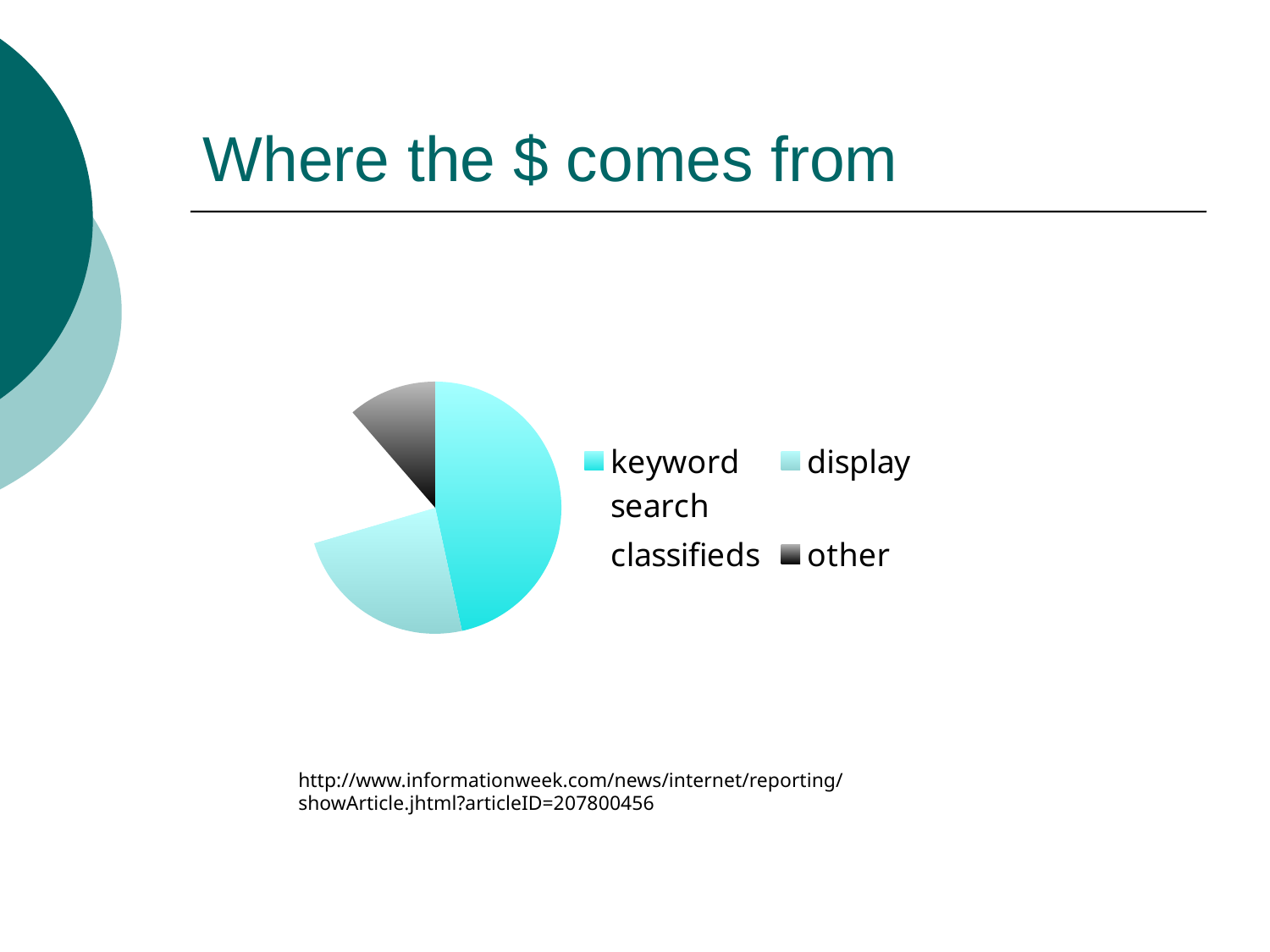
Which legend entry in the pie chart is shown in dark gray? other How many categories does the pie chart's legend list? 4 Which category has the largest slice in the pie chart? keyword search Which slice is larger in the pie chart, keyword search or display? keyword search What is the title of the slide containing the pie chart? Where the $ comes from Which slice is larger in the pie chart, keyword search or other? keyword search Which slice is larger in the pie chart, display or other? display What kind of chart is shown on the slide? pie chart